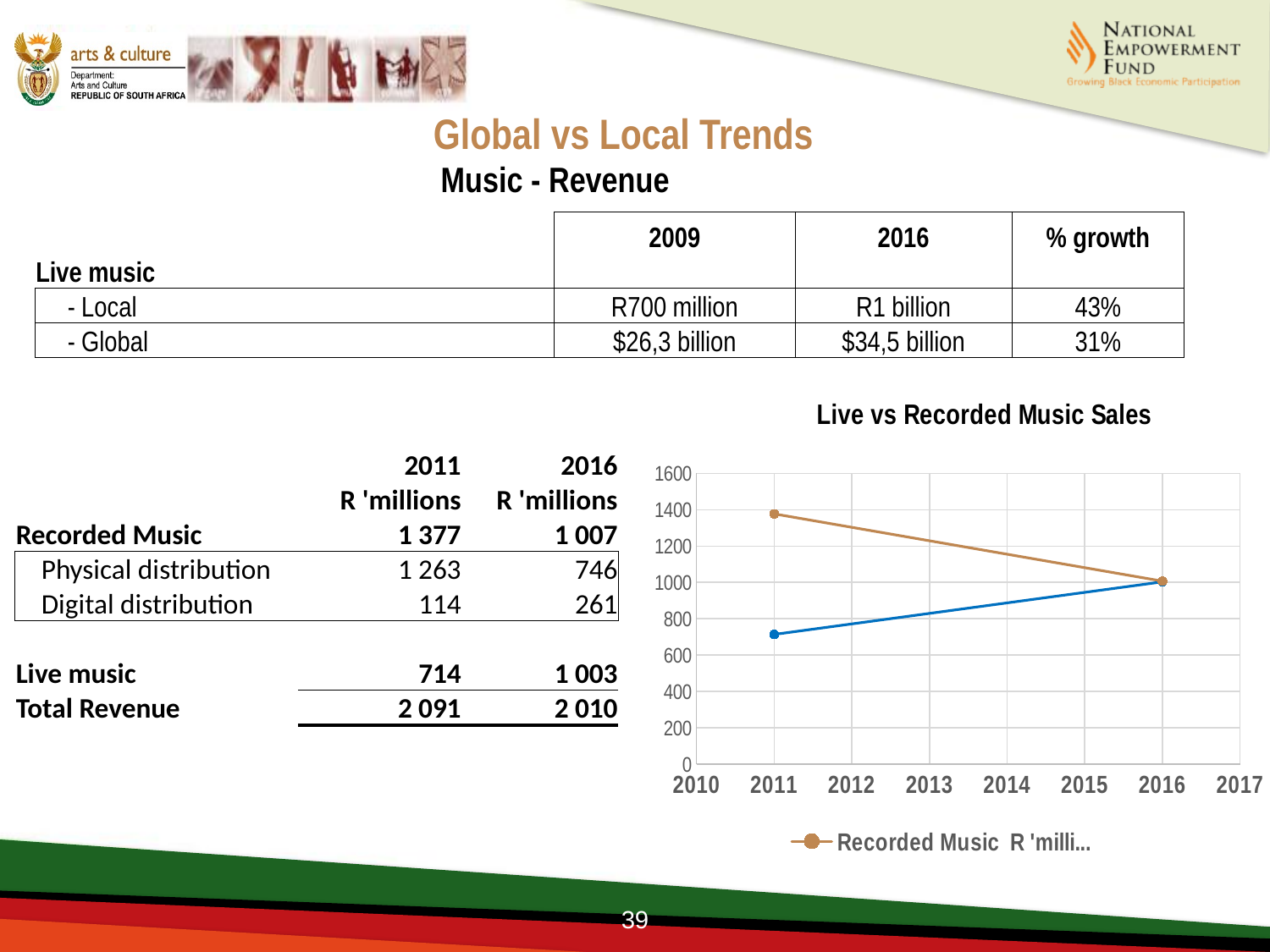
In the 'Live vs Recorded Music Sales' chart, is the Recorded Music value for 2011 greater or less than 1200? greater In the 'Live vs Recorded Music Sales' chart, does the blue line rise or fall from 2011 to 2016? Rise What is the highest value shown on the y-axis of the 'Live vs Recorded Music Sales' chart? 1600 In the 'Live vs Recorded Music Sales' chart, is the blue line's value for 2011 greater or less than 800? less In the 'Live vs Recorded Music Sales' chart, is the blue line's value for 2016 greater or less than 800? greater How many data points does each line in the 'Live vs Recorded Music Sales' chart have? 2 What type of chart is shown under the heading 'Live vs Recorded Music Sales'? Line chart How many lines are plotted in the 'Live vs Recorded Music Sales' chart? 2 In the 'Live vs Recorded Music Sales' chart, which line is higher in 2011, the Recorded Music line or the blue line? Recorded Music line In the 'Live vs Recorded Music Sales' chart, does the Recorded Music line rise or fall from 2011 to 2016? Fall What is the title of the chart on the right side of the slide? Live vs Recorded Music Sales